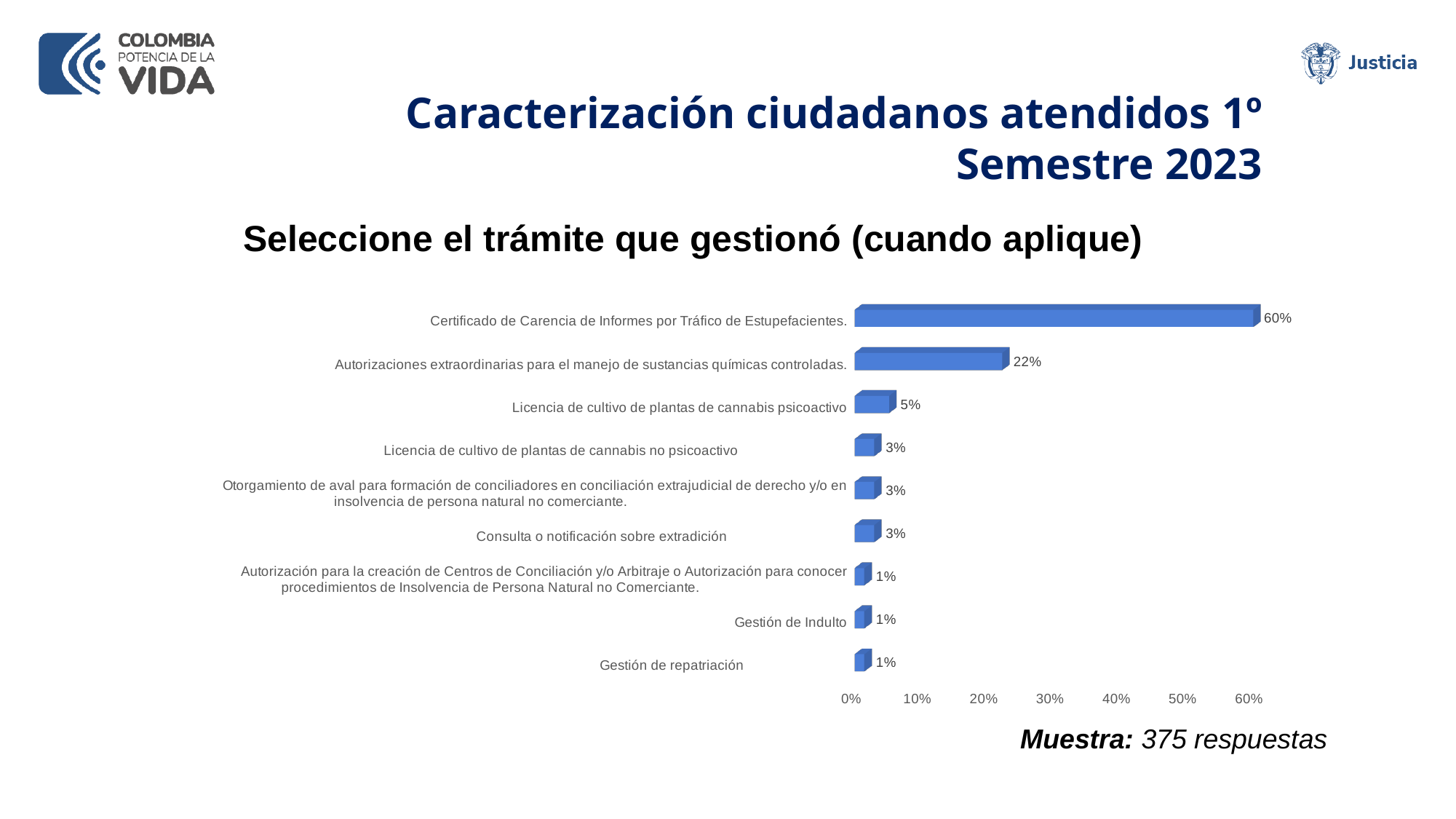
What is the value for "Consulta o notificación sobre extradición"? 3% What is the value for "Licencia de cultivo de plantas de cannabis psicoactivo"? 5% What is the difference between the values for "Certificado de Carencia de Informes por Tráfico de Estupefacientes." and "Autorizaciones extraordinarias para el manejo de sustancias químicas controladas."? 38% What kind of chart is shown on the slide? bar chart Which category has the highest value? Certificado de Carencia de Informes por Tráfico de Estupefacientes. What is the value for "Gestión de Indulto"? 1% How many categories are shown in the chart? 9 Which is larger: the value for "Licencia de cultivo de plantas de cannabis psicoactivo" or the value for "Licencia de cultivo de plantas de cannabis no psicoactivo"? Licencia de cultivo de plantas de cannabis psicoactivo Is the value for "Autorizaciones extraordinarias para el manejo de sustancias químicas controladas." greater or less than 30%? less What is the value for "Certificado de Carencia de Informes por Tráfico de Estupefacientes."? 60% What is the title of the chart? Seleccione el trámite que gestionó (cuando aplique) What is the value for "Autorizaciones extraordinarias para el manejo de sustancias químicas controladas."? 22%